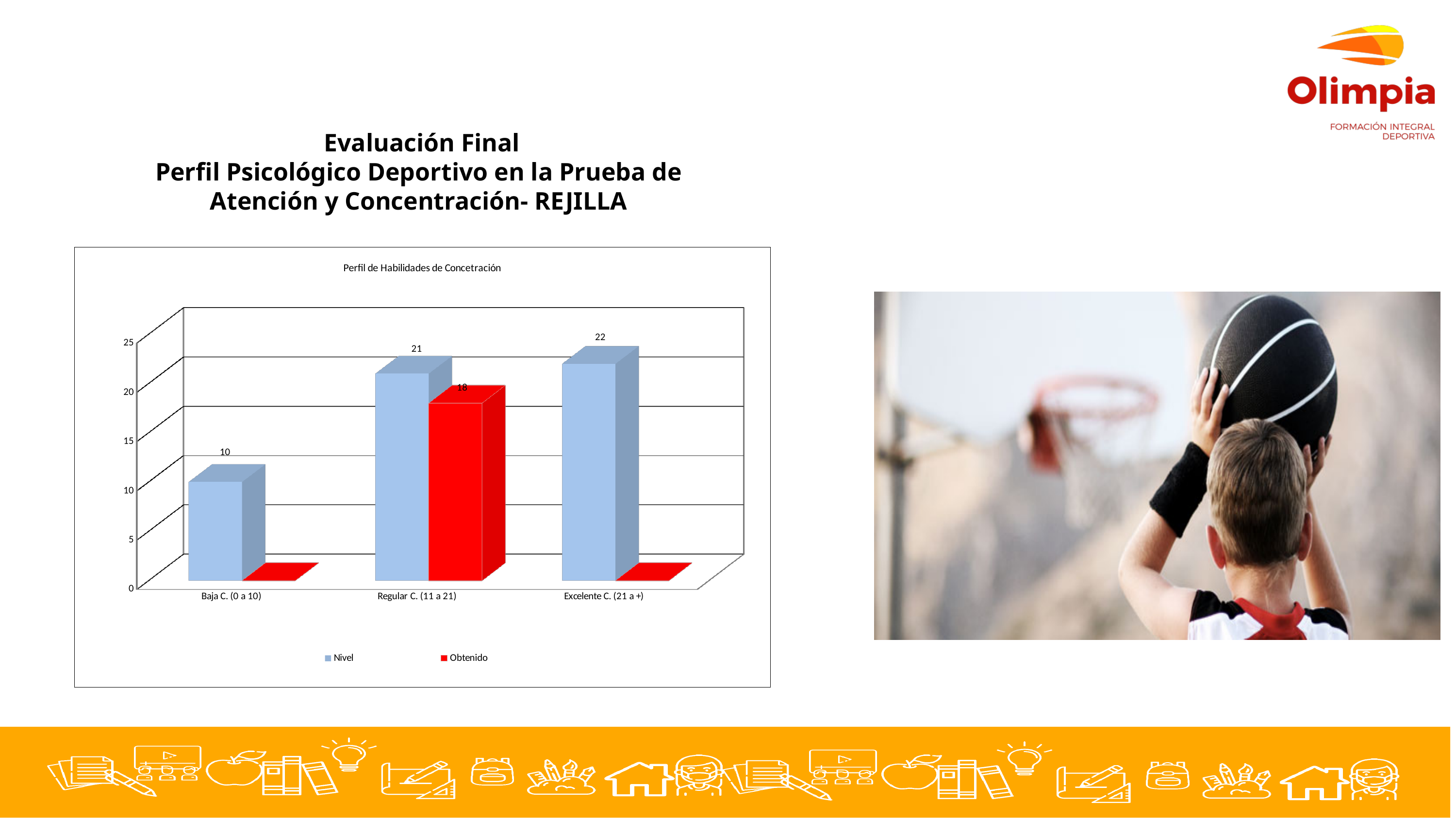
Which category has the highest Nivel value? Excelente C. (21 a +) What is the title of the chart? Perfil de Habilidades de Concetración Which is larger for Regular C. (11 a 21), the Nivel value or the Obtenido value? Nivel How many series does the legend list? 2 Which category has the lowest Nivel value? Baja C. (0 a 10) What kind of chart is shown? Bar chart How many categories are shown on the x axis? 3 What is the difference between the Nivel and Obtenido values for Regular C. (11 a 21)? 3 What is the Nivel value for Excelente C. (21 a +)? 22 What is the Nivel value for Baja C. (0 a 10)? 10 What is the Nivel value for Regular C. (11 a 21)? 21 What is the Obtenido value for Regular C. (11 a 21)? 18